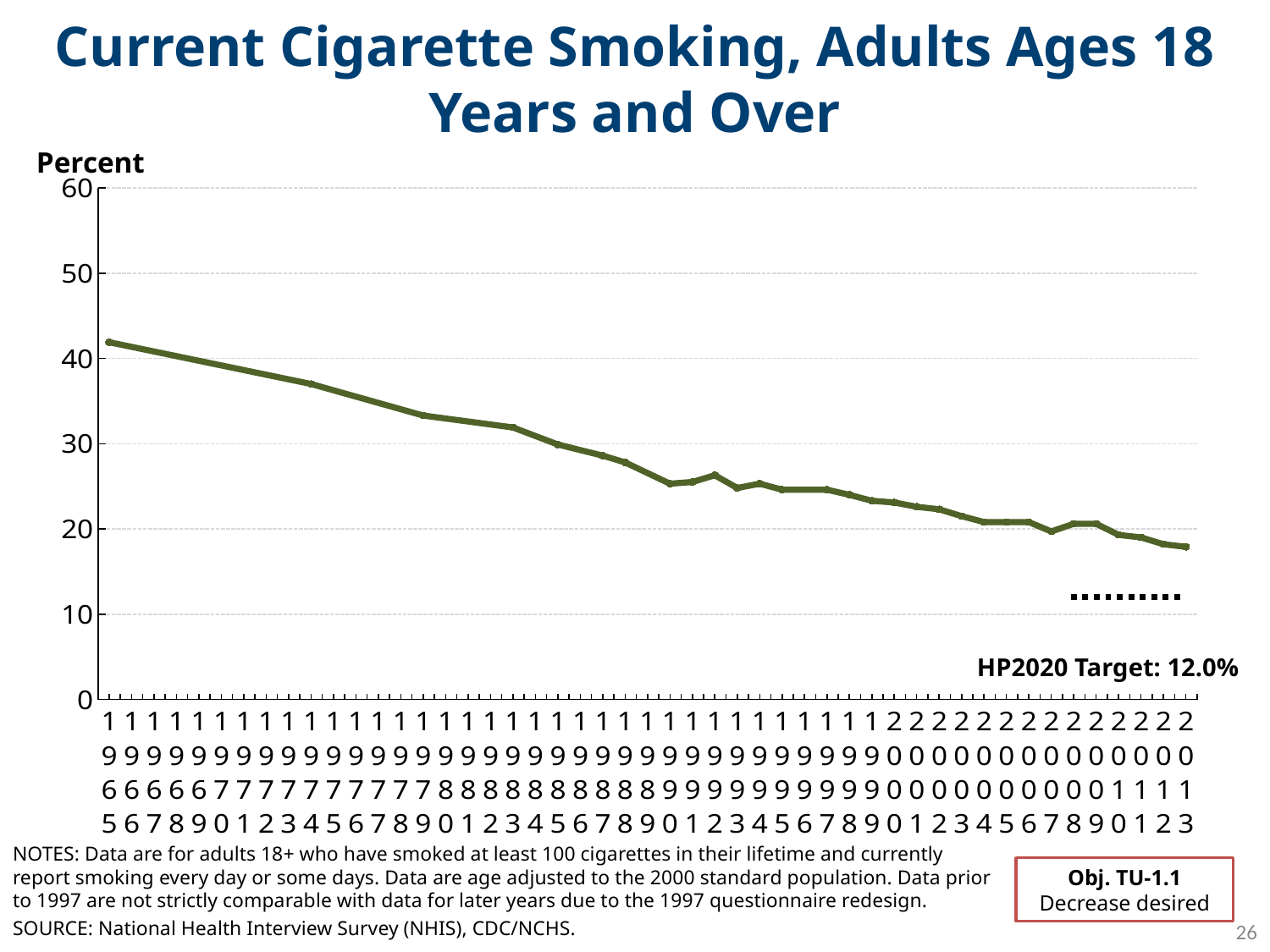
What is the label on the y axis? Percent Which year has the lowest percent of current cigarette smoking? 2013 Is the value for 1990 greater or less than 30? less Do the values for current cigarette smoking generally rise or fall from 1965 to 2013? fall What is the HP2020 Target shown on the chart? 12.0% Is the value for 2013 greater or less than 20? less Is the value for 1965 greater or less than 40? greater What kind of chart is shown on the slide? line chart Which year has the highest percent of current cigarette smoking? 1965 How many years are plotted on the x axis? 49